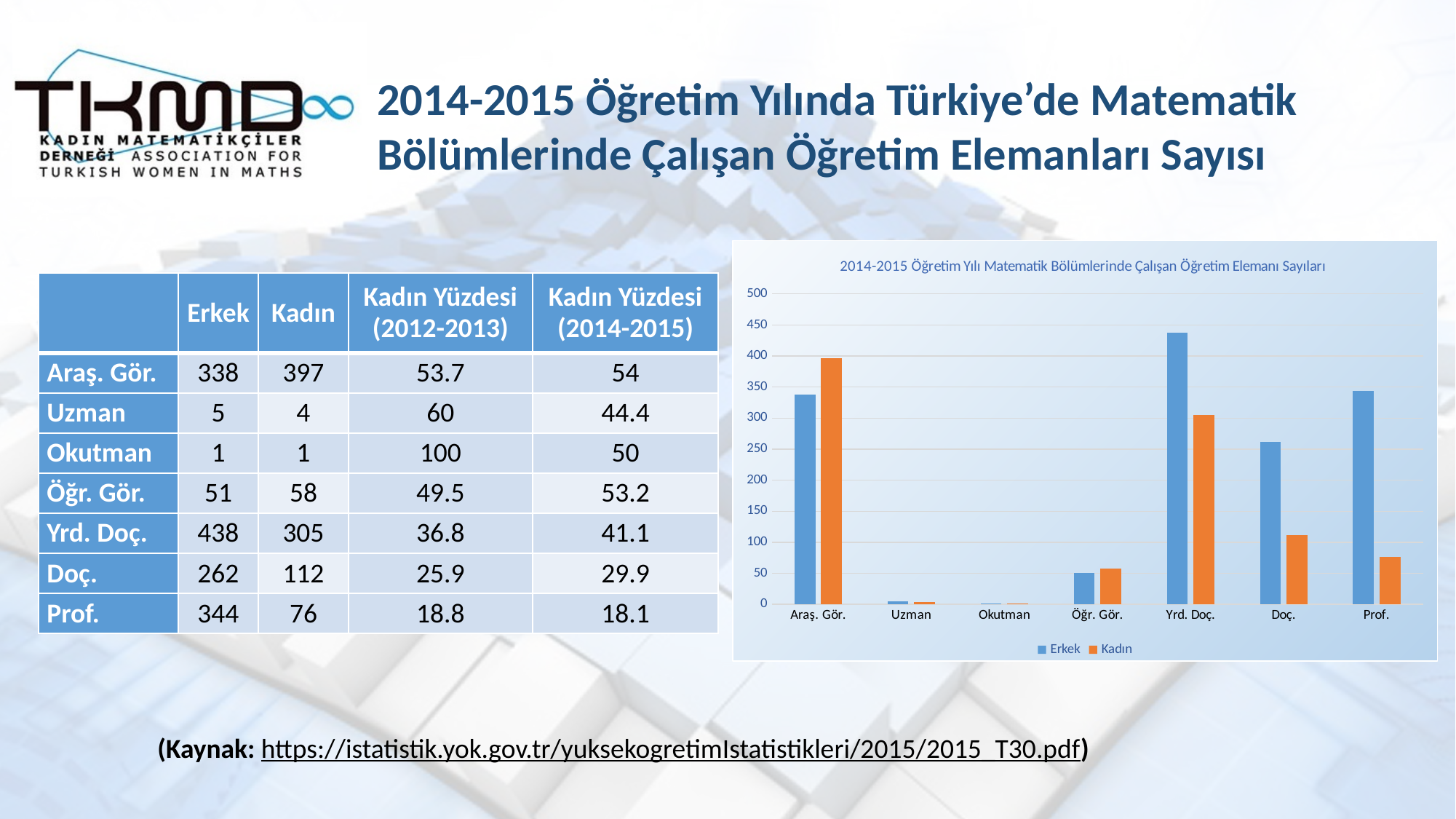
Is the Kadın value for Prof. greater or less than 100? less Which category has the highest Kadın value in the chart? Araş. Gör. Which category has the highest Erkek value in the chart? Yrd. Doç. What kind of chart is shown on the slide? bar chart How many categories are shown on the x axis of the chart? 7 How many series does the chart legend list? 2 What is the Erkek value for Doç. as printed in the table on the slide? 262 For Araş. Gör., which is larger, the Erkek bar or the Kadın bar? Kadın Which colour represents the Kadın series in the chart? orange For Prof., which is larger, the Erkek bar or the Kadın bar? Erkek Is the Erkek value for Yrd. Doç. greater or less than 400? greater